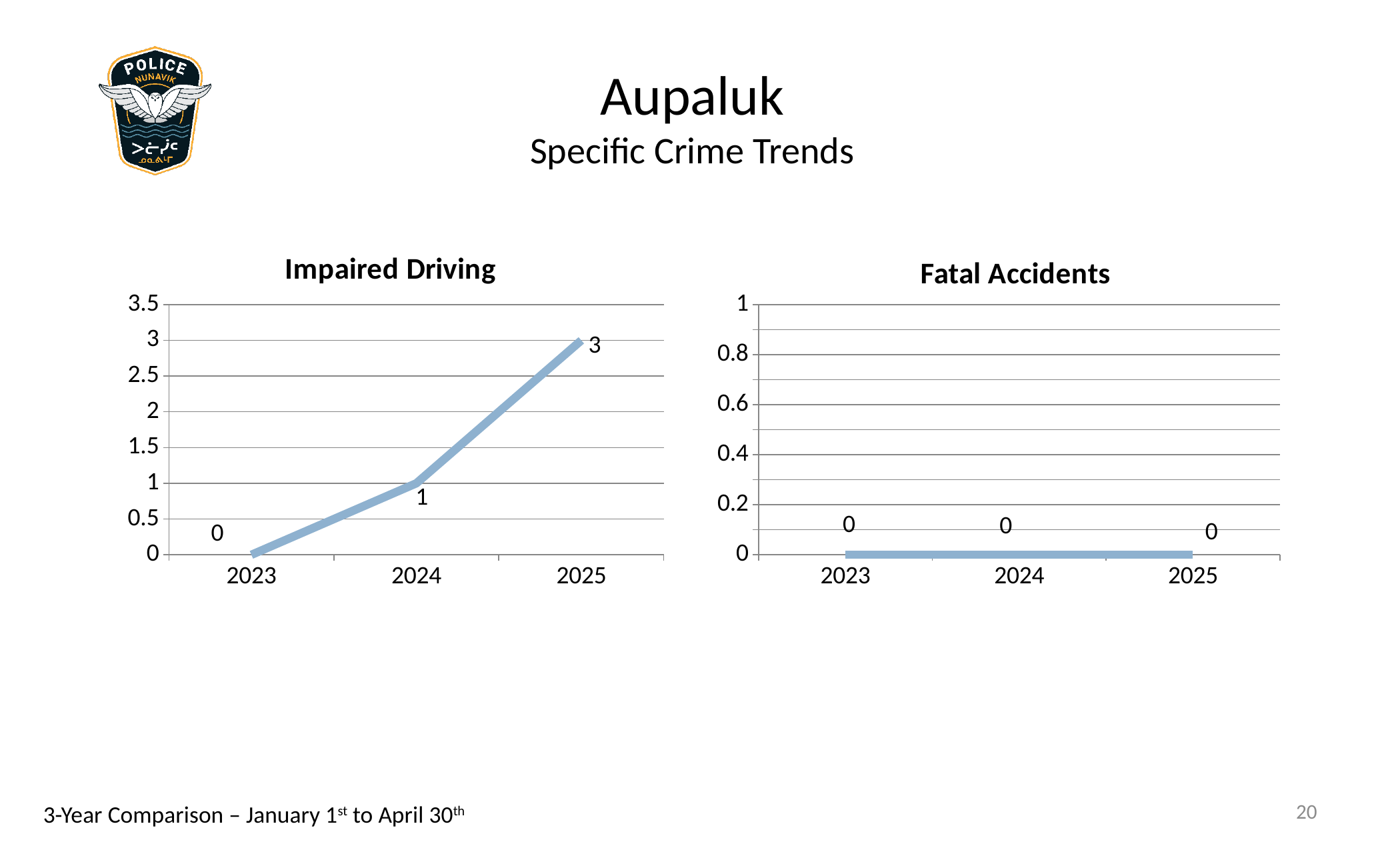
What is the title of the chart on the right side of the slide? Fatal Accidents In the Impaired Driving chart, what is the value for 2025? 3 In the Impaired Driving chart, do the values rise or fall from 2023 to 2025? rise In the Impaired Driving chart, what is the value for 2024? 1 What kind of chart is the Impaired Driving chart? line chart How many years are plotted in the Fatal Accidents chart? 3 In the Impaired Driving chart, which year has the lowest value? 2023 In the Impaired Driving chart, what is the value for 2023? 0 In the Impaired Driving chart, which is larger, the value for 2024 or the value for 2025? 2025 In the Fatal Accidents chart, what is the value for 2024? 0 In the Impaired Driving chart, what is the difference between the 2025 and 2024 values? 2 In the Impaired Driving chart, which year has the highest value? 2025